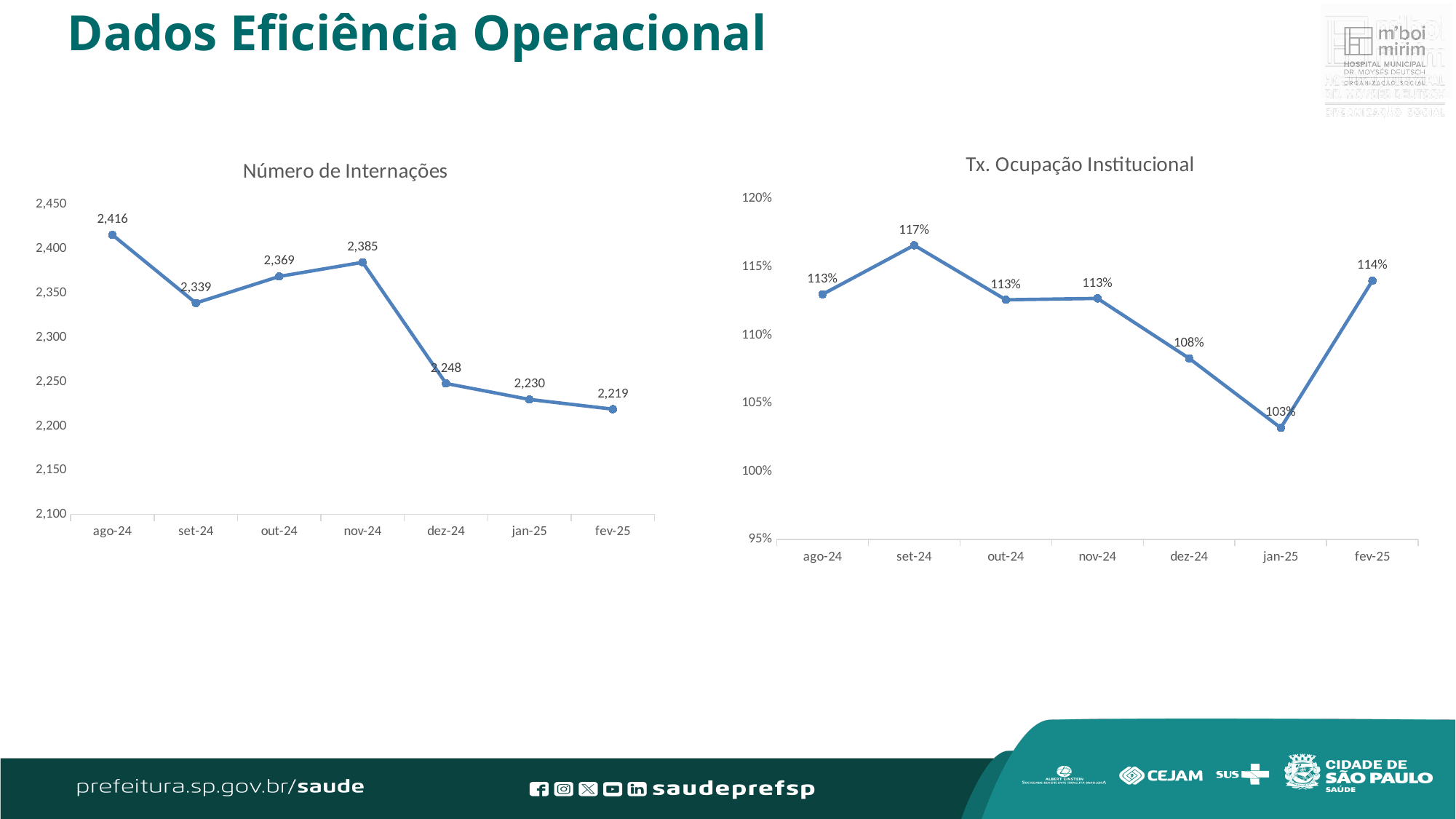
In the 'Número de Internações' chart, which is larger, the value for set-24 or the value for out-24? out-24 In the 'Número de Internações' chart, which month has the lowest value? fev-25 In the 'Tx. Ocupação Institucional' chart, which month has the lowest value? jan-25 In the 'Número de Internações' chart, what is the difference between the values for ago-24 and fev-25? 197 In the 'Número de Internações' chart, how many months are plotted? 7 In the 'Número de Internações' chart, what is the value for nov-24? 2,385 In the 'Tx. Ocupação Institucional' chart, what is the value for jan-25? 103% In the 'Tx. Ocupação Institucional' chart, what is the difference between the values for set-24 and jan-25? 14% What kind of chart is 'Número de Internações'? line chart In the 'Número de Internações' chart, which month has the highest value? ago-24 In the 'Tx. Ocupação Institucional' chart, is the value for dez-24 greater or less than 110%? less In the 'Tx. Ocupação Institucional' chart, which month has the highest value? set-24